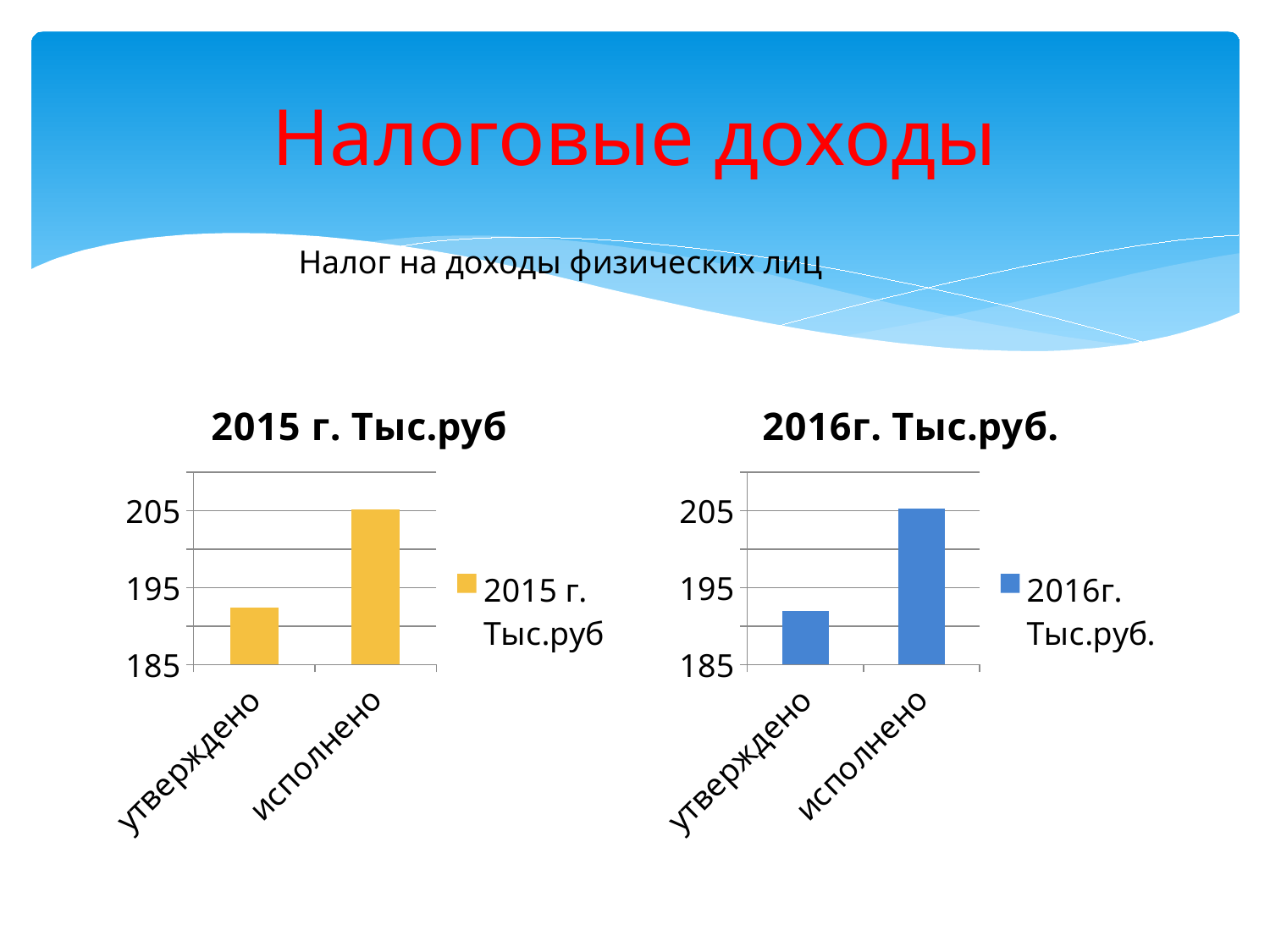
In the chart titled "2016г. Тыс.руб.", which category has the lowest value? утверждено In the chart titled "2015 г. Тыс.руб", which category has the highest value? исполнено In the chart titled "2016г. Тыс.руб.", is the value for исполнено greater or less than 195? greater In the chart titled "2015 г. Тыс.руб", which is larger, утверждено or исполнено? исполнено What colour are the bars in the chart titled "2015 г. Тыс.руб"? yellow In the chart titled "2016г. Тыс.руб.", is the value for утверждено greater or less than 185? greater In the chart titled "2015 г. Тыс.руб", is the value for утверждено greater or less than 195? less What is the legend entry of the chart on the right side of the slide? 2016г. Тыс.руб. What kind of chart is the chart titled "2015 г. Тыс.руб"? bar chart What kind of chart is the chart titled "2016г. Тыс.руб."? bar chart In the chart titled "2015 г. Тыс.руб", how many categories are shown on the x axis? 2 In the chart titled "2016г. Тыс.руб.", how many series does the legend list? 1